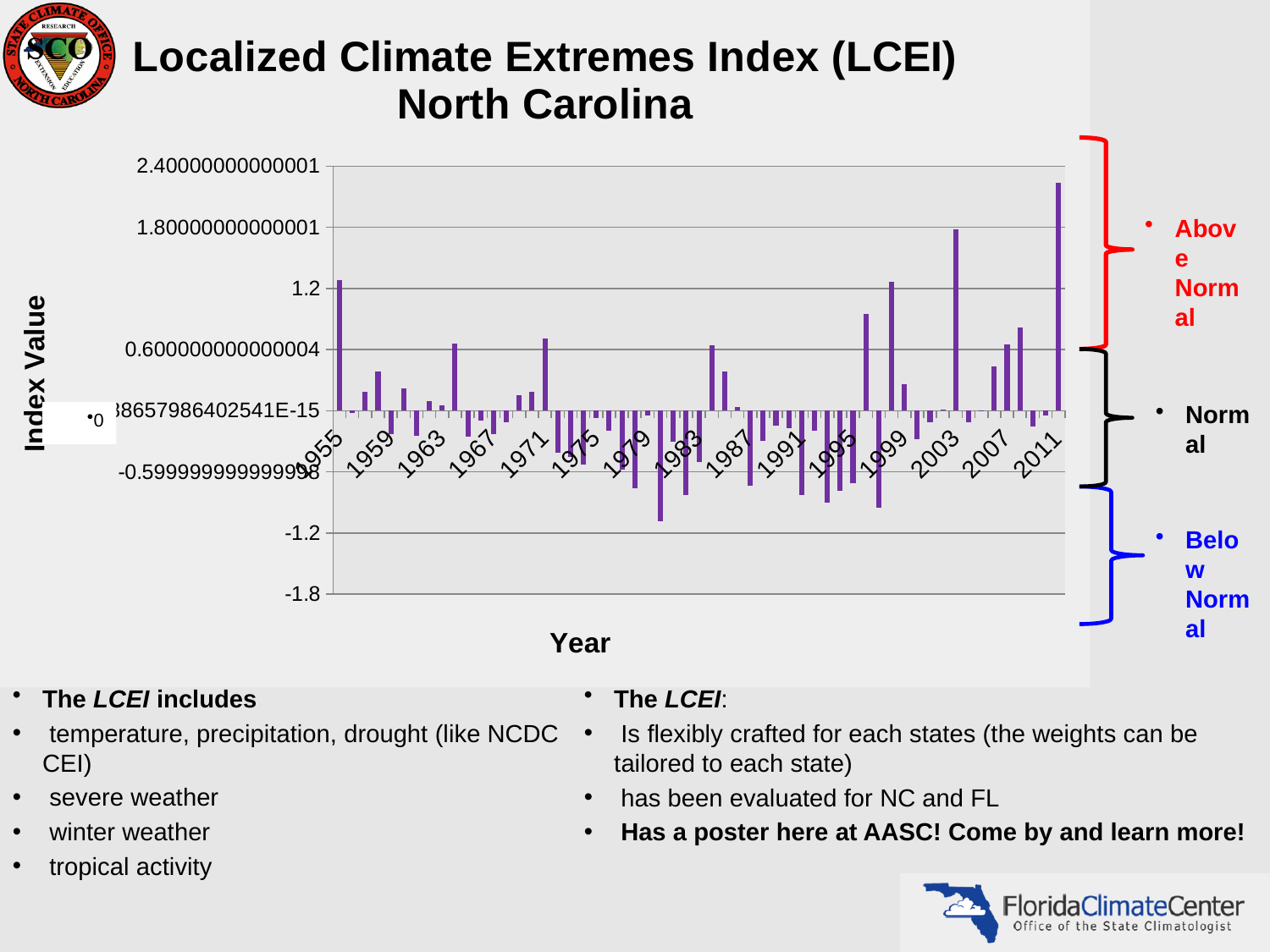
Which year has the highest index value in the chart? 2011 How many year labels are printed along the x axis? 15 What kind of chart is shown on the slide? bar chart Which has the larger index value, 1955 or 2011? 2011 Is the index value for 1955 greater or less than 0.6? greater What is the last year label shown on the x axis? 2011 What is the title of the x axis? Year What is the lowest tick value shown on the y axis? -1.8 What is the title of the y axis? Index Value Is the index value for 2011 greater or less than 1.8? greater What is the first year label shown on the x axis? 1955